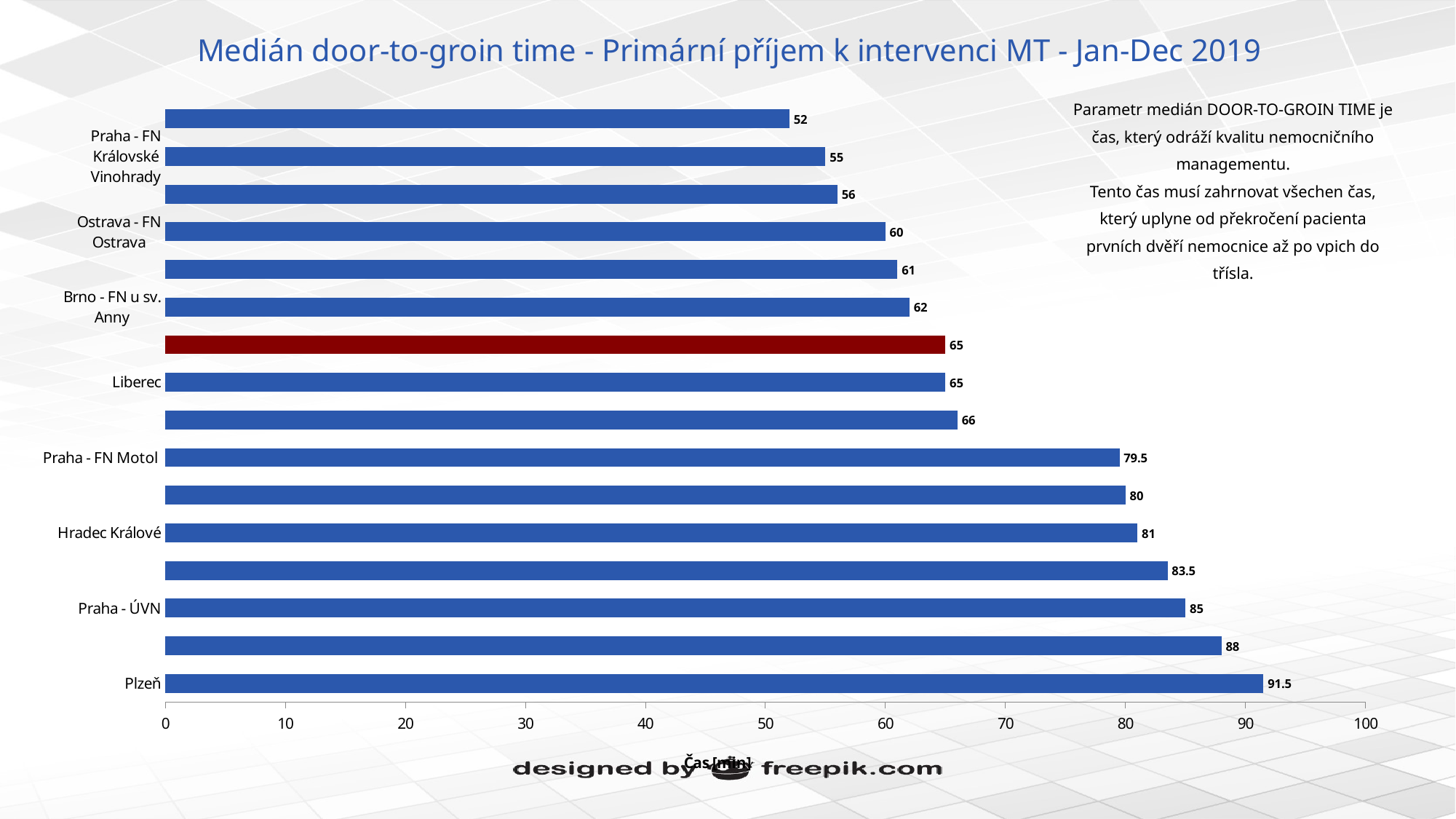
Which labelled hospital has the highest median door-to-groin time? Plzeň What is the lowest value shown on the chart? 52 What is the difference between the values for Plzeň and Praha - ÚVN? 6.5 What is the value of the bar highlighted in dark red? 65 What is the title of the chart? Medián door-to-groin time - Primární příjem k intervenci MT - Jan-Dec 2019 What kind of chart is shown on the slide? bar chart What is the median door-to-groin time for Plzeň? 91.5 What is the value for Ostrava - FN Ostrava? 60 What is the value for Praha - FN Motol? 79.5 What is the value for Hradec Králové? 81 Which has a larger value, Liberec or Brno - FN u sv. Anny? Liberec How many bars are plotted on the chart? 16